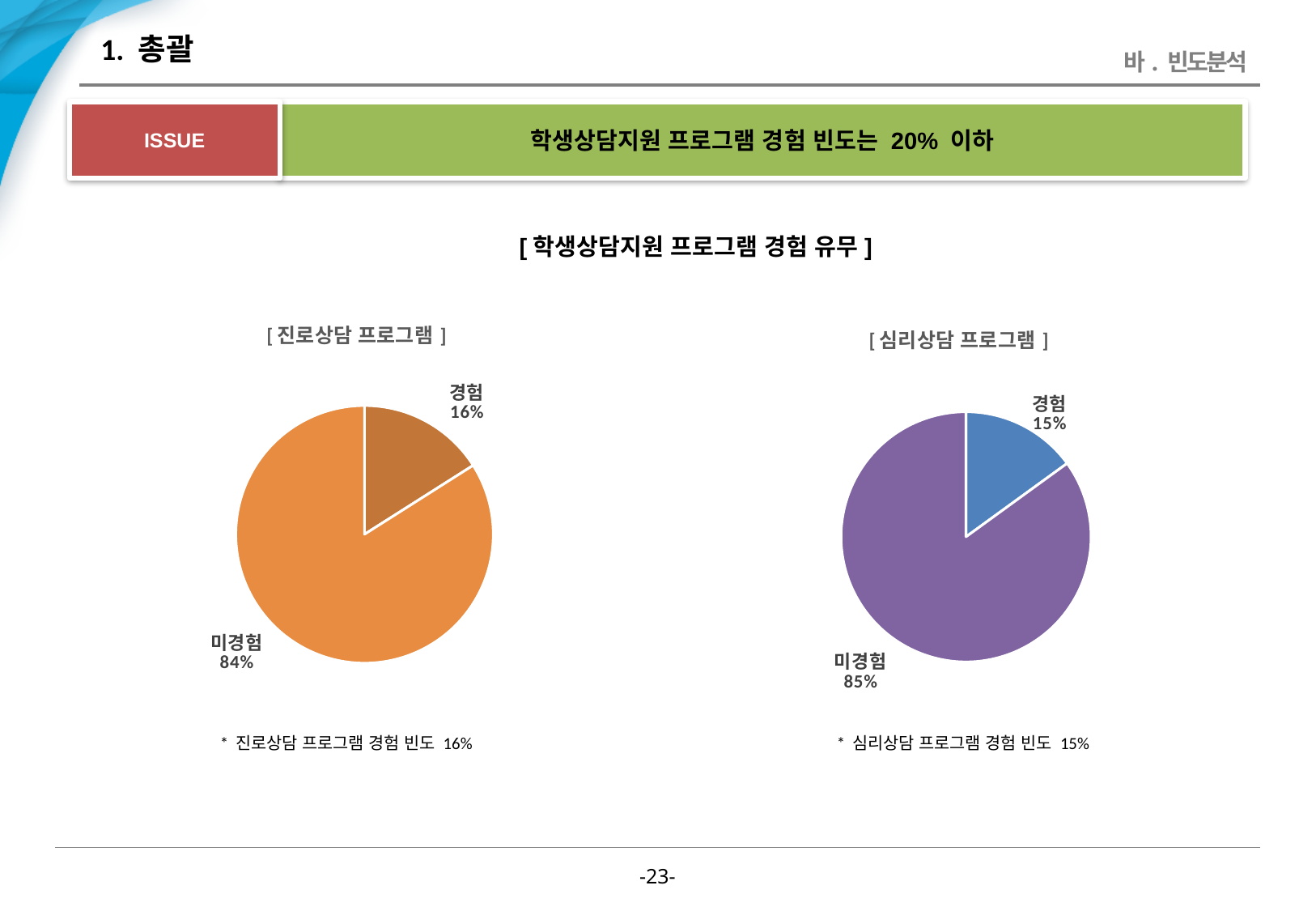
In the [진로상담 프로그램] chart, what percentage is shown for 미경험? 84% In the [심리상담 프로그램] chart, what percentage is shown for 경험? 15% In the [심리상담 프로그램] chart, what percentage is shown for 미경험? 85% In the [진로상담 프로그램] chart, which slice is the smallest? 경험 What kind of chart is the [진로상담 프로그램] chart? Pie chart In the [진로상담 프로그램] chart, what percentage is shown for 경험? 16% In the [심리상담 프로그램] chart, what is the difference between the 미경험 and 경험 percentages? 70% In the [진로상담 프로그램] chart, what is the difference between the 미경험 and 경험 percentages? 68% What is the overall title shown above the two pie charts? [ 학생상담지원 프로그램 경험 유무 ] In the [심리상담 프로그램] chart, which slice is the largest? 미경험 How many slices does the [심리상담 프로그램] pie chart have? 2 Which is larger: the 경험 share in the [진로상담 프로그램] chart or the 경험 share in the [심리상담 프로그램] chart? 진로상담 프로그램